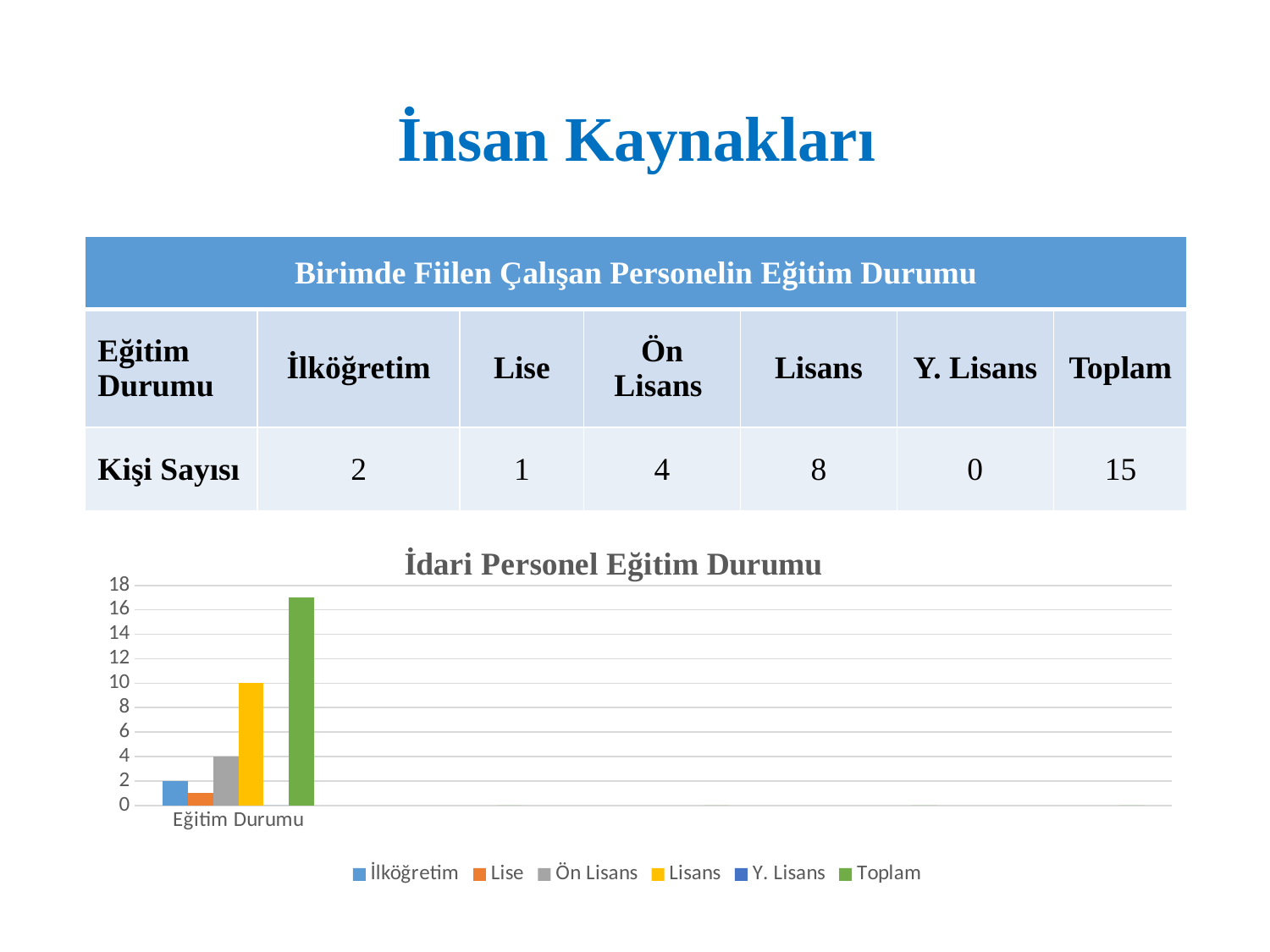
What is the value of the Ön Lisans bar in the chart? 4 Which series has the tallest bar in the chart? Toplam How many categories are shown on the x axis of the chart? 1 Is the value of the Lise bar greater or less than 2? less What is the value of the İlköğretim bar in the chart? 2 What is the difference between the Lisans bar and the Ön Lisans bar in the chart? 6 Which bar is taller in the chart, Lise or Ön Lisans? Ön Lisans How many series does the chart legend list? 6 What is the value of the Lisans bar in the chart? 10 Is the value of the Toplam bar greater or less than 16? greater What is the title of the chart? İdari Personel Eğitim Durumu What type of chart is shown on the slide? bar chart